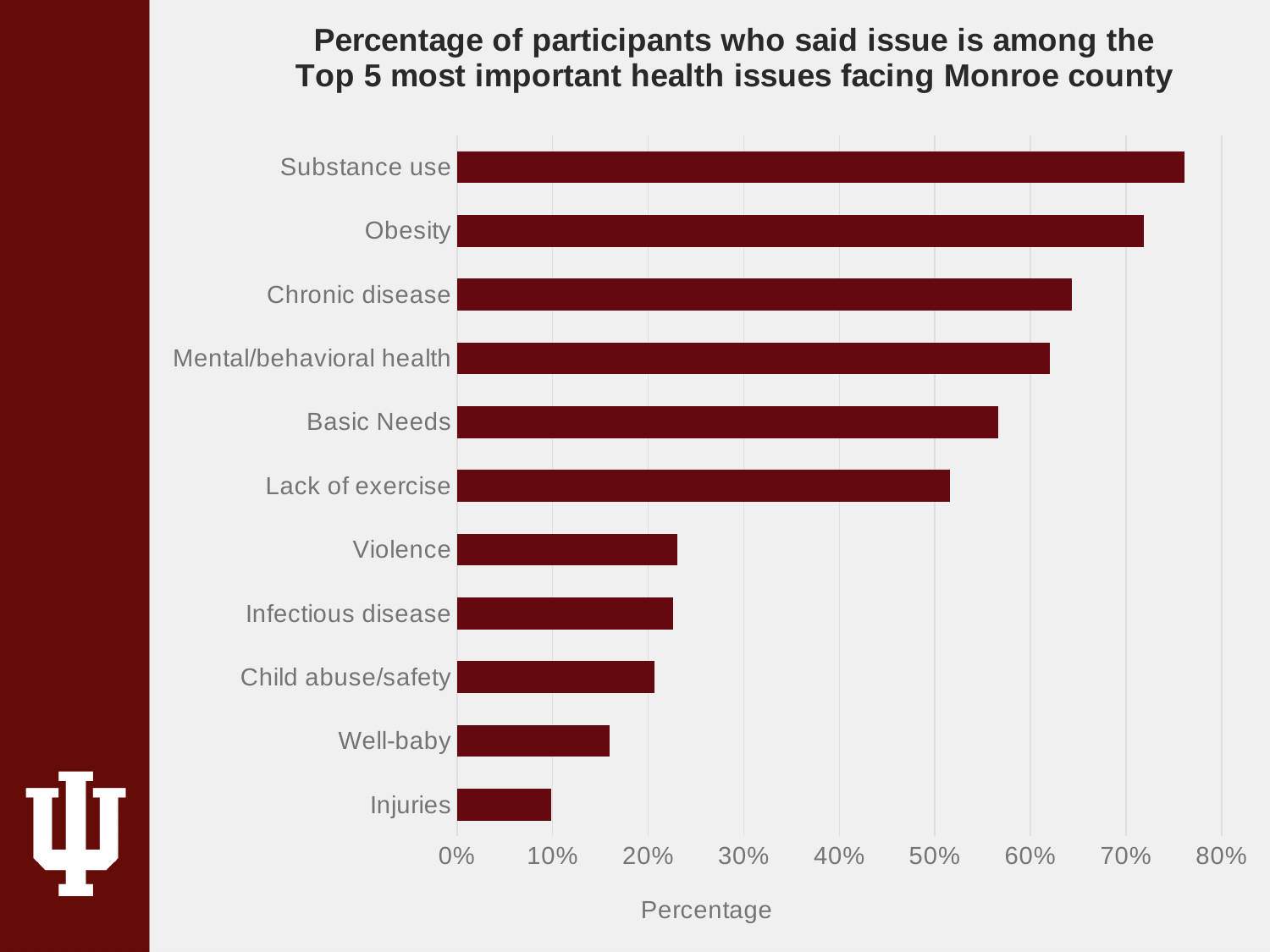
Is the value for Substance use greater or less than 70%? greater How many health issues are listed on the chart? 11 What kind of chart is shown on the slide? bar chart Which health issue has the lowest percentage of participants? Injuries Which health issue has the highest percentage of participants? Substance use Which is larger, the value for Child abuse/safety or the value for Well-baby? Child abuse/safety Is the value for Well-baby greater or less than 20%? less Is the value for Violence greater or less than 30%? less What is the label of the horizontal axis? Percentage Which is larger, the value for Basic Needs or the value for Lack of exercise? Basic Needs